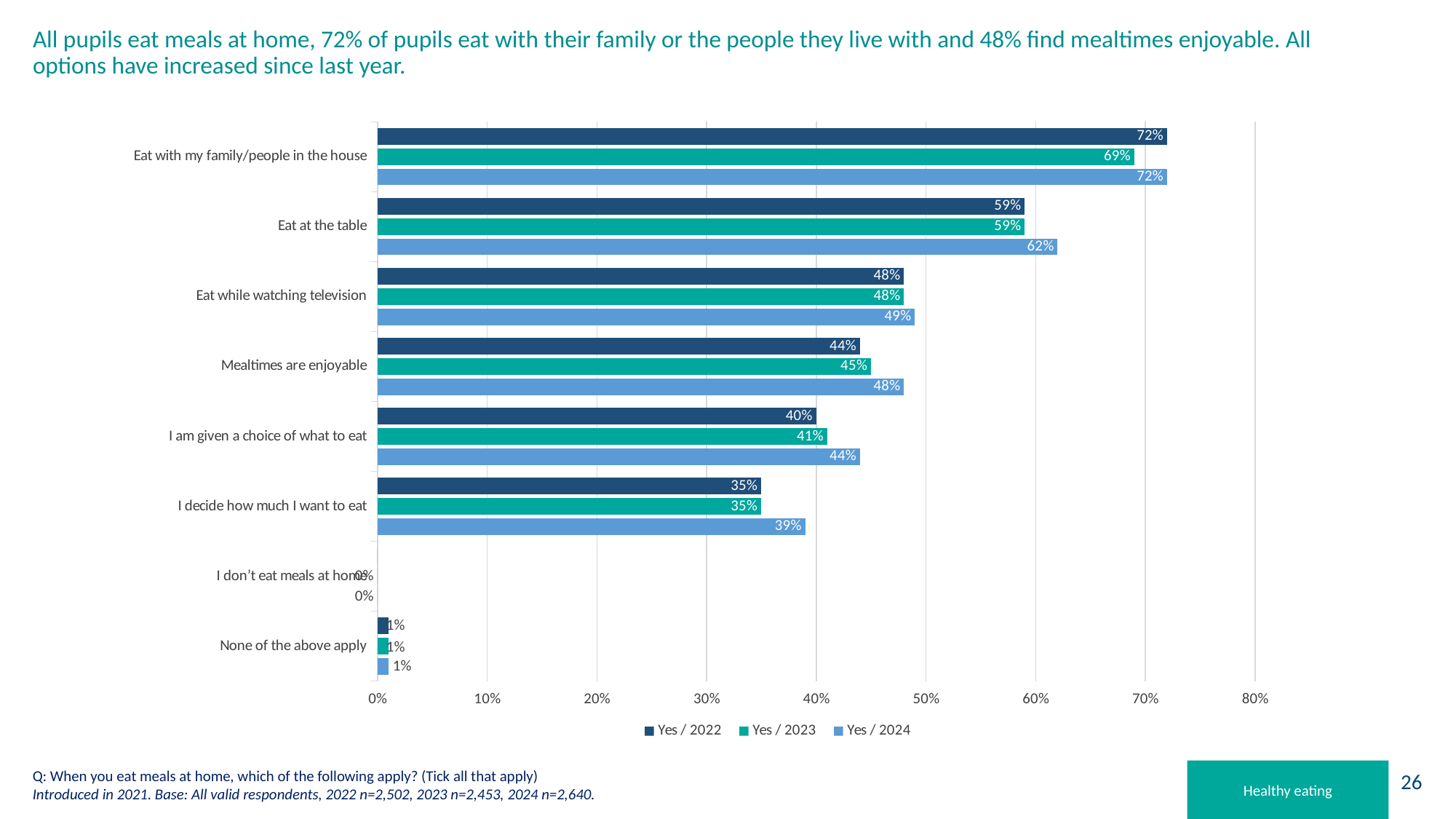
What is the value for 'I decide how much I want to eat' in the Yes / 2023 series? 35% What is the value for 'Mealtimes are enjoyable' in the Yes / 2022 series? 44% Which is larger for 'Eat with my family/people in the house': the Yes / 2023 value or the Yes / 2024 value? Yes / 2024 What are the three legend entries on the chart? Yes / 2022, Yes / 2023, Yes / 2024 Which category has the highest value in the Yes / 2024 series? Eat with my family/people in the house What kind of chart is shown on the slide? Bar chart Which category has the lowest value in the Yes / 2023 series? I don't eat meals at home How many series does the legend list? 3 What is the value for 'Eat at the table' in the Yes / 2024 series? 62% How many categories are shown on the chart? 8 What is the difference between the Yes / 2024 and Yes / 2022 values for 'I am given a choice of what to eat'? 4 percentage points What is the value for 'Eat while watching television' in the Yes / 2024 series? 49%